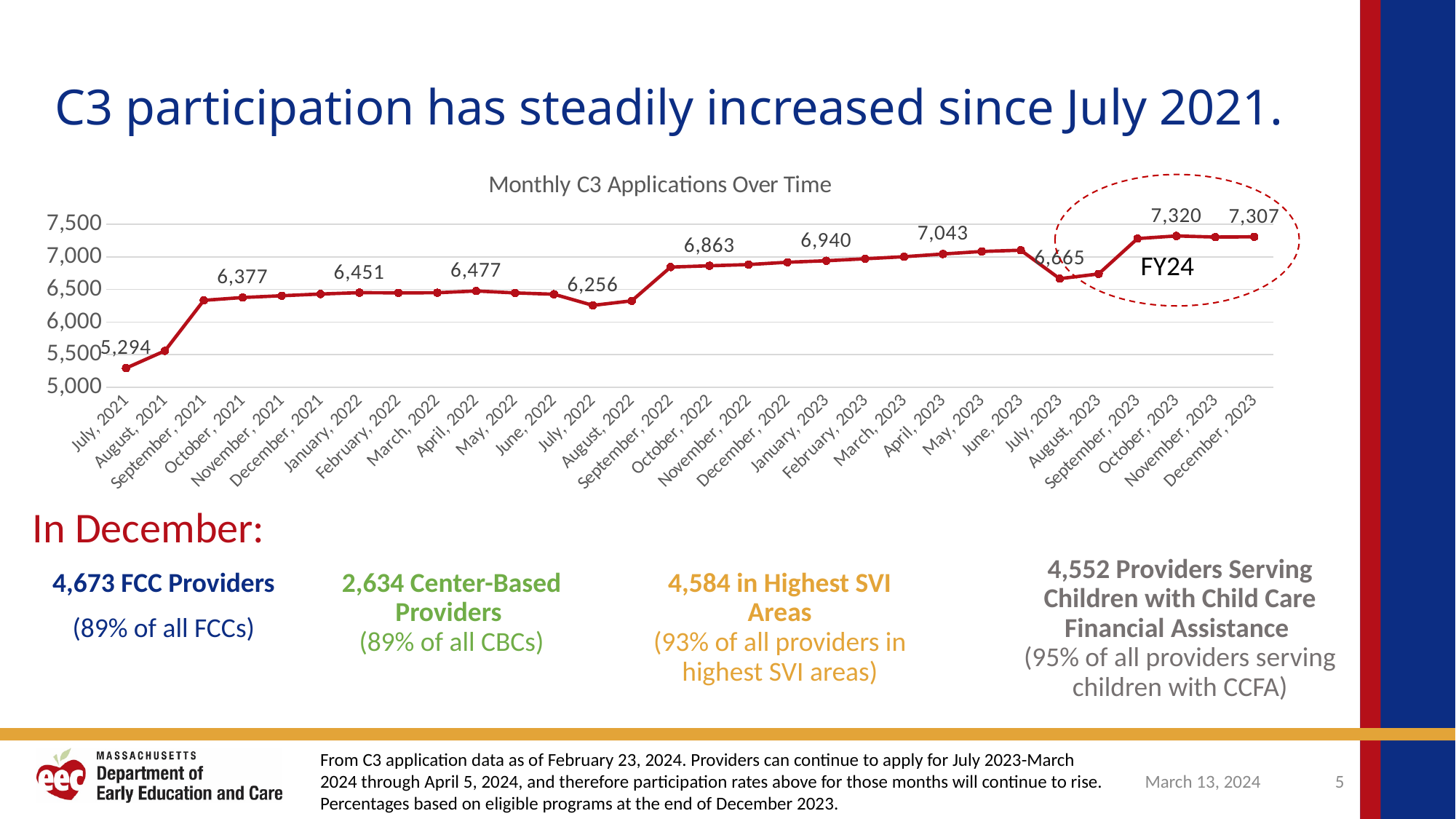
Do the values generally rise or fall from July 2021 to December 2023? Rise What is the title of the chart? Monthly C3 Applications Over Time What is the value for December, 2023? 7,307 Which is larger, the value for July, 2022 or the value for September, 2022? September, 2022 What is the value for July, 2021? 5,294 How many monthly data points are plotted on the chart? 30 What is the value for April, 2023? 7,043 Is the value for August, 2021 greater or less than 6,000? less What kind of chart is shown on the slide? Line chart What is the value for October, 2023? 7,320 What is the difference between the values for December, 2023 and July, 2021? 2,013 Which month has the lowest value on the chart? July, 2021